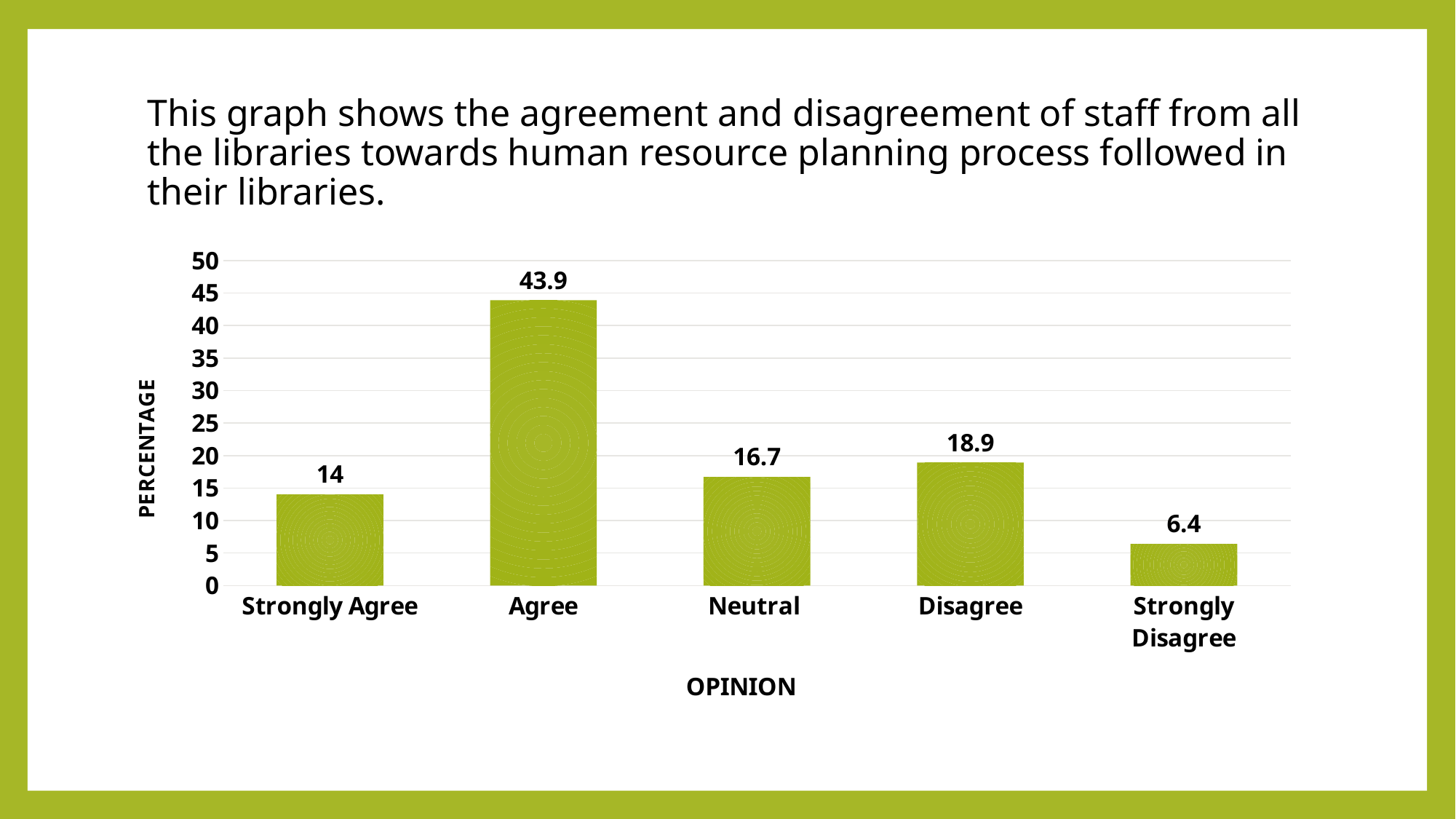
What is the percentage for Neutral? 16.7 What is the label of the vertical axis? PERCENTAGE What kind of chart is shown on the slide? bar chart Is the value for Disagree greater or less than 20? less Which opinion has the lowest percentage? Strongly Disagree What is the difference between the percentages for Disagree and Neutral? 2.2 What is the percentage for Agree? 43.9 Which is larger, the percentage for Strongly Agree or for Neutral? Neutral How many opinion categories are shown on the chart? 5 Which opinion has the highest percentage? Agree What is the difference between the percentages for Agree and Disagree? 25 What is the percentage for Strongly Disagree? 6.4